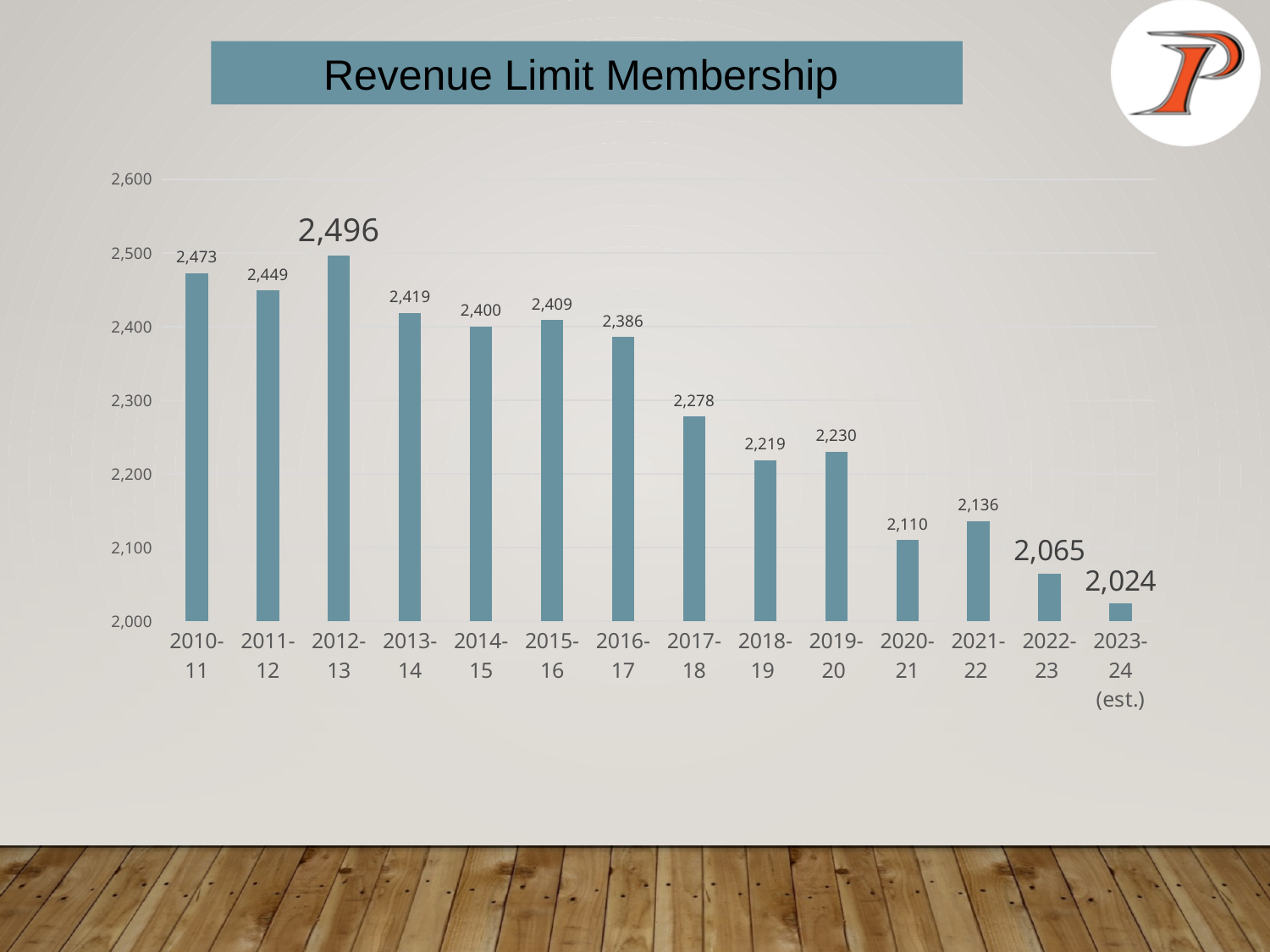
What kind of chart is shown on the slide? bar chart What is the difference in membership between 2010-11 and 2023-24 (est.)? 449 What is the revenue limit membership for 2012-13? 2,496 Which year has a larger membership, 2014-15 or 2015-16? 2015-16 Which year has the highest revenue limit membership? 2012-13 What is the overall trend in revenue limit membership from 2010-11 to 2023-24? falling Which year has the lowest revenue limit membership? 2023-24 (est.) What is the revenue limit membership for 2017-18? 2,278 What is the difference in membership between 2018-19 and 2019-20? 11 Is the membership for 2020-21 greater or less than 2,200? less What is the estimated revenue limit membership for 2023-24? 2,024 How many years are shown on the chart? 14